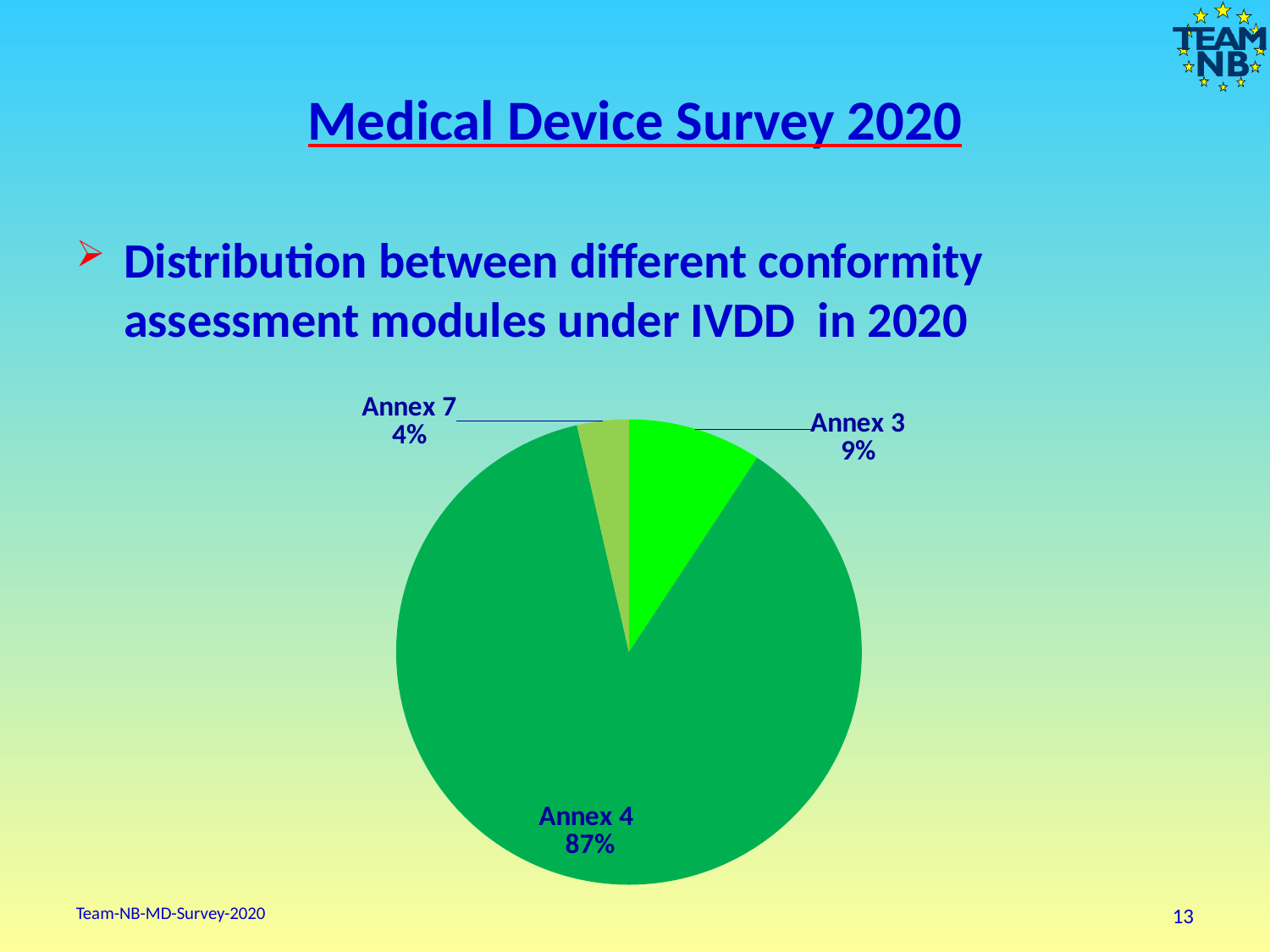
What is the difference in percentage points between the shares of Annex 4 and Annex 3? 78 What kind of chart is shown on the slide? Pie chart Which annex has the smallest share of the pie? Annex 7 What share of the pie does Annex 4 represent? 87% How many slices does the pie chart have? 3 Which annex has the largest share of the pie? Annex 4 What is the difference in percentage points between the shares of Annex 3 and Annex 7? 5 What share of the pie does Annex 3 represent? 9% What share of the pie does Annex 7 represent? 4% Which has a larger share, Annex 3 or Annex 7? Annex 3 What is the combined share of Annex 3 and Annex 7? 13% What does the chart show, according to the bullet text above it? Distribution between different conformity assessment modules under IVDD in 2020